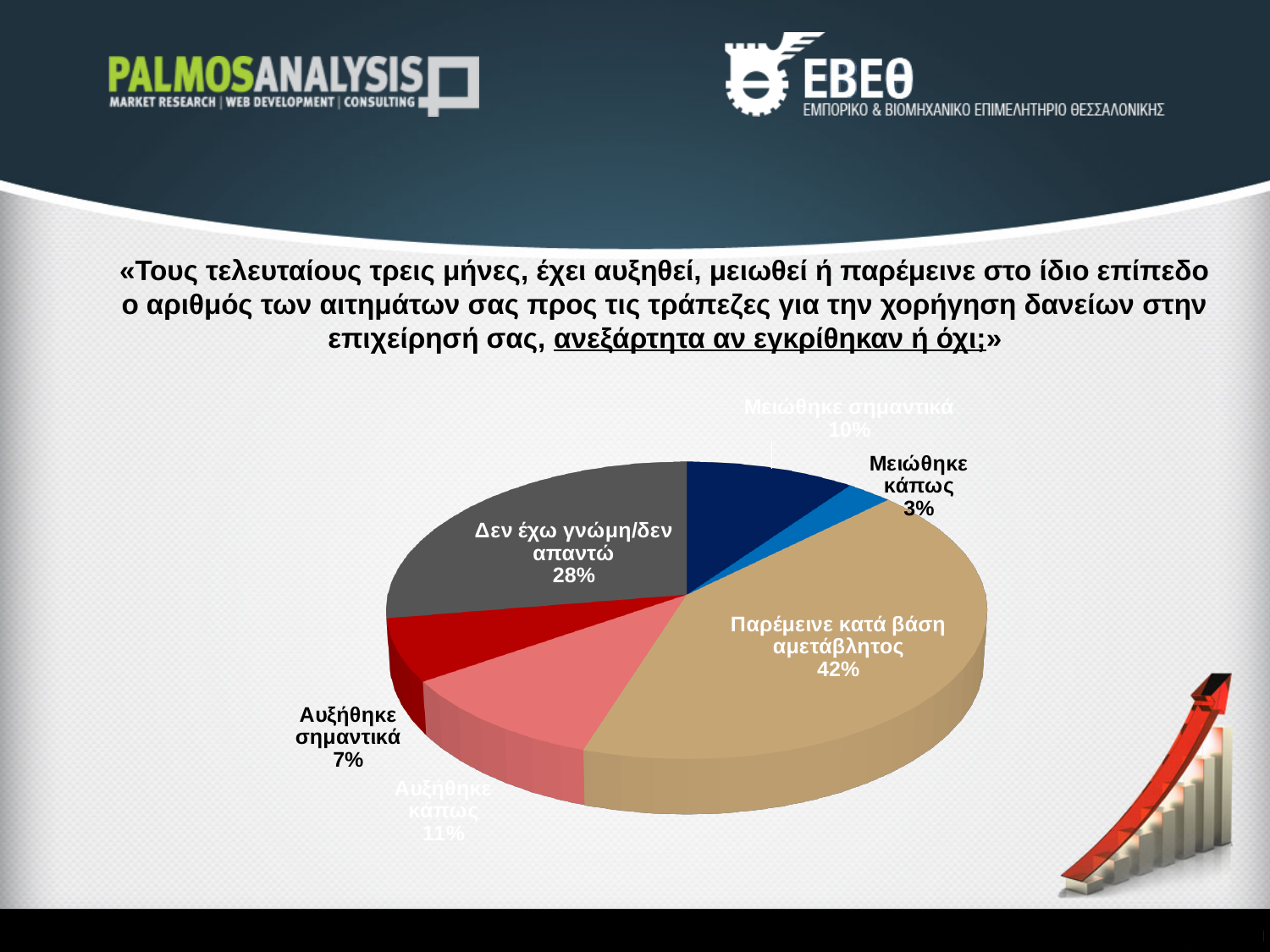
What percentage of respondents answered «Δεν έχω γνώμη/δεν απαντώ»? 28% Which response has the smallest share of the pie? Μειώθηκε κάπως How many slices does the pie chart have? 6 What percentage of respondents answered «Παρέμεινε κατά βάση αμετάβλητος»? 42% Which response has the largest share of the pie? Παρέμεινε κατά βάση αμετάβλητος Which is larger: the share for «Μειώθηκε σημαντικά» or the share for «Αυξήθηκε σημαντικά»? Μειώθηκε σημαντικά What percentage of respondents answered «Αυξήθηκε κάπως»? 11% What percentage of respondents answered «Μειώθηκε κάπως»? 3% What type of chart is shown on the slide? Pie chart What is the difference in percentage points between «Παρέμεινε κατά βάση αμετάβλητος» and «Δεν έχω γνώμη/δεν απαντώ»? 14 percentage points What colour is the slice for «Παρέμεινε κατά βάση αμετάβλητος»? Beige/tan What percentage of respondents answered «Αυξήθηκε σημαντικά»? 7%